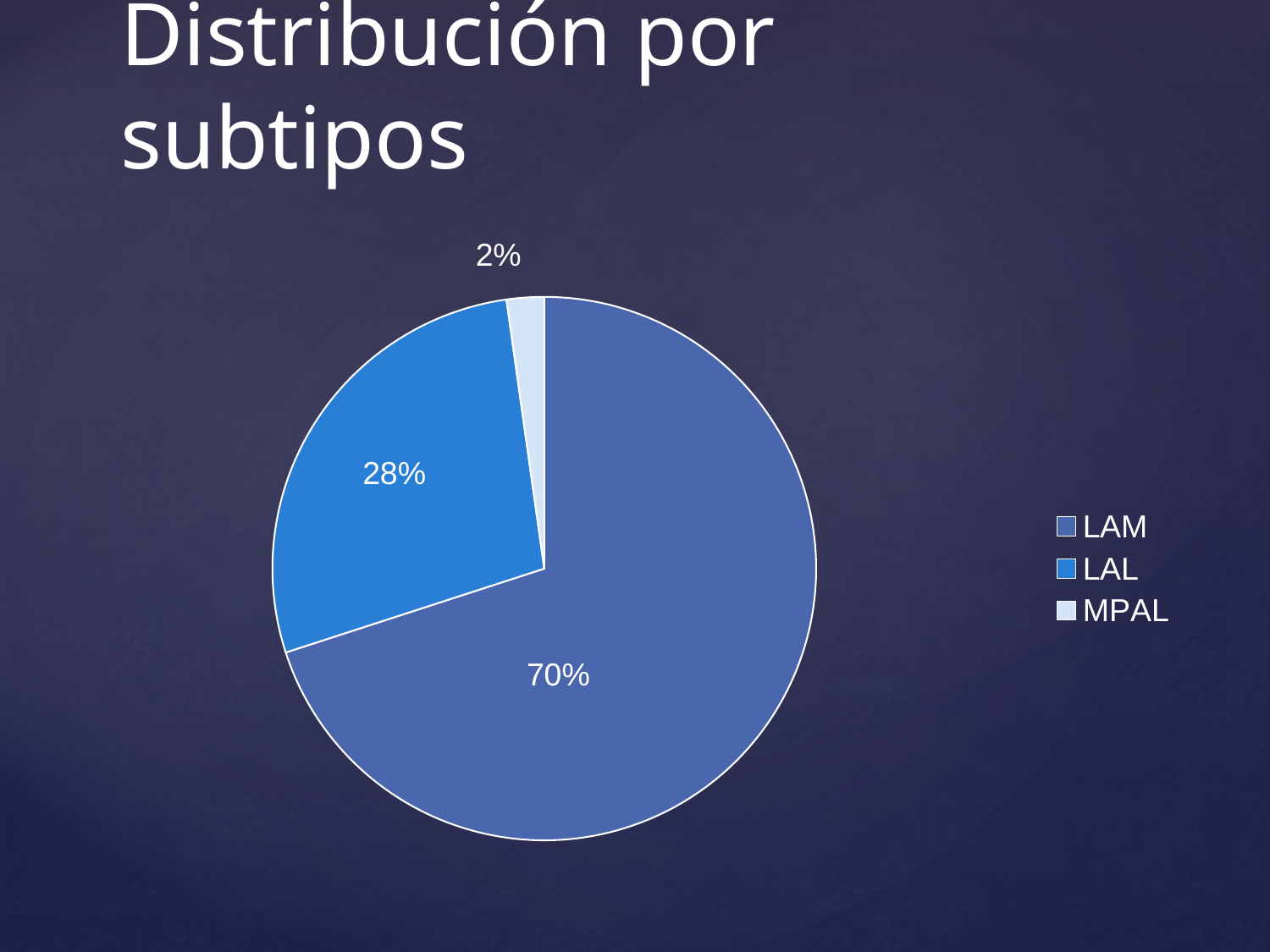
Which slice is larger, LAL or MPAL? LAL How many slices does the pie chart have? 3 What is the difference in percentage points between the LAL and MPAL slices? 26 What share of the pie does LAM represent? 70% What is the difference in percentage points between the LAM and LAL slices? 42 What share of the pie does MPAL represent? 2% Which subtype has the largest slice of the pie? LAM What is the title of the slide containing the pie chart? Distribución por subtipos What kind of chart is shown on the slide? pie chart Which subtype has the smallest slice of the pie? MPAL What share of the pie does LAL represent? 28% How many entries does the legend list? 3